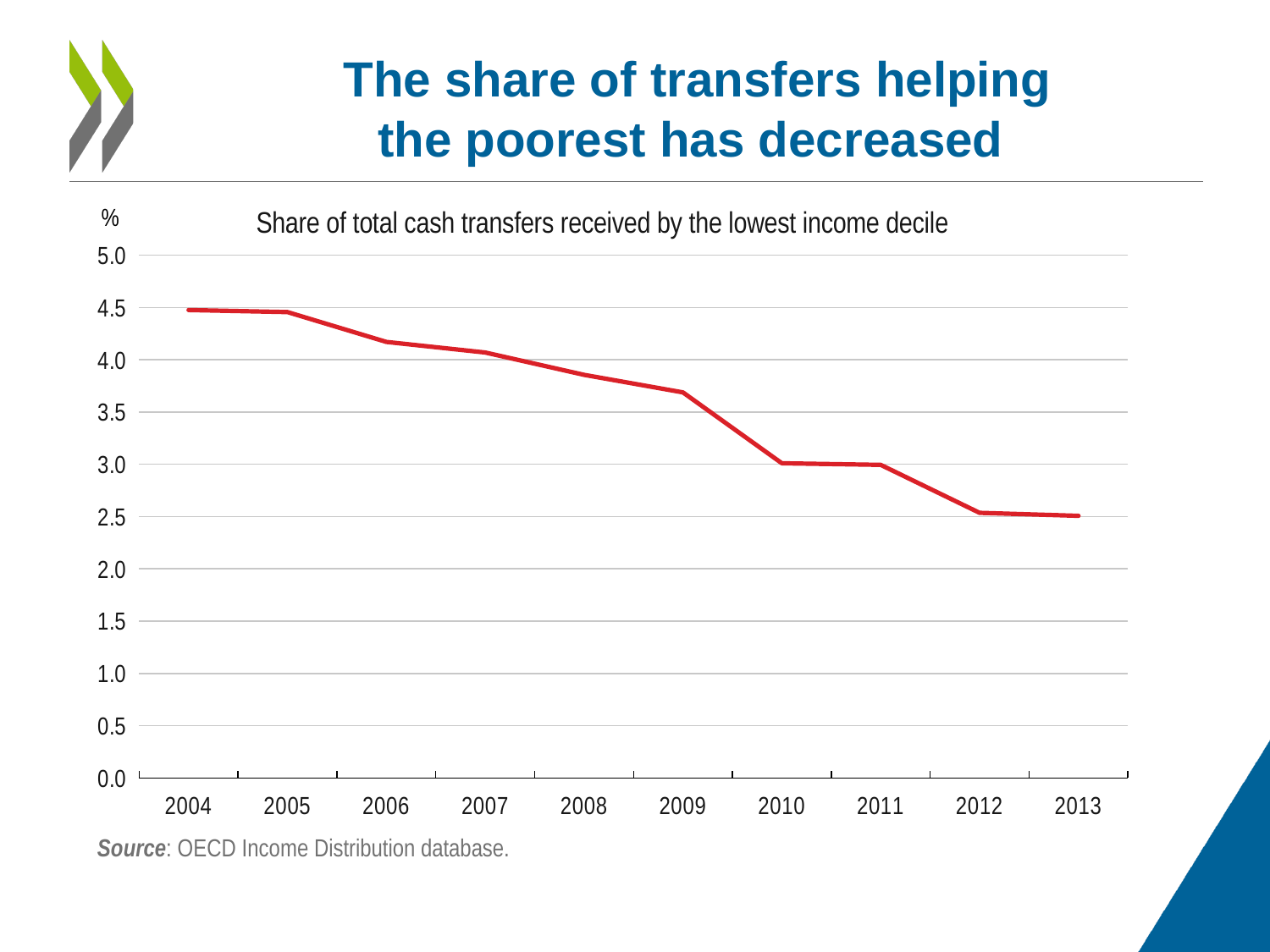
Is the value for 2008 greater or less than 4.0? less Does the share of total cash transfers received by the lowest income decile rise or fall from 2004 to 2013? fall Which year has the larger value, 2004 or 2013? 2004 Is the value for 2004 greater or less than 4.0? greater Is the value for 2006 greater or less than 4.0? greater What kind of chart is shown on the slide? line chart What is the source cited below the chart? OECD Income Distribution database How many years are shown on the x axis of the chart? 10 What is the title of the chart? Share of total cash transfers received by the lowest income decile